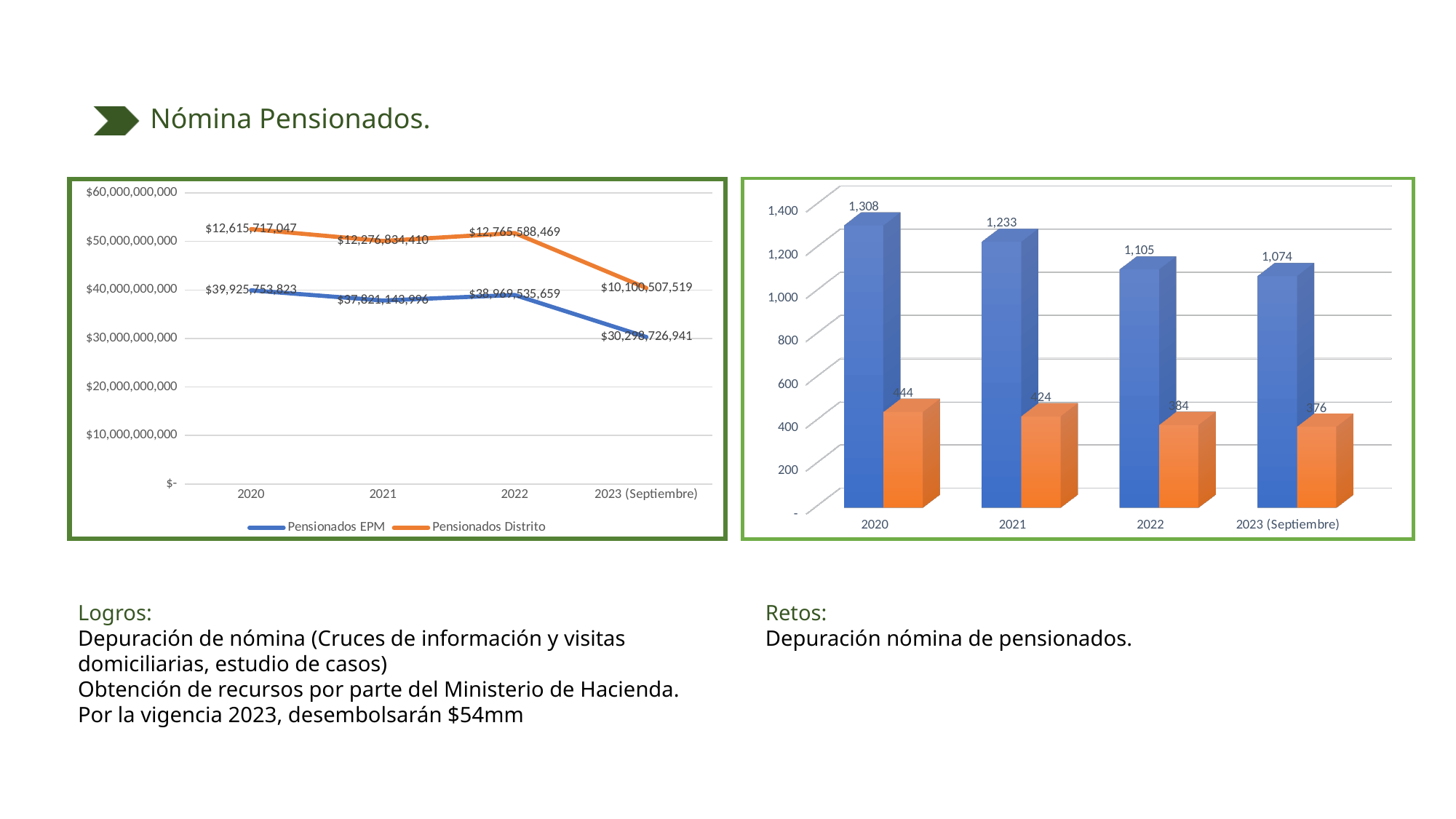
On the left chart, in which year is the Pensionados EPM value highest? 2020 What kind of chart is the chart on the right? Bar chart On the right chart, what is the value of the orange bar for 2022? 384 On the right chart, what is the value of the blue bar for 2021? 1,233 On the left chart, what is the value for Pensionados EPM in 2023 (Septiembre)? $30,298,726,941 On the left chart, in which year is the Pensionados Distrito value lowest? 2023 (Septiembre) On the left chart, how many series does the legend list? 2 On the left chart, what is the value for Pensionados Distrito in 2021? $12,276,834,410 On the right chart, do the blue bar values rise or fall from 2020 to 2023 (Septiembre)? Fall On the right chart, what is the difference between the blue bar values for 2020 and 2023 (Septiembre)? 234 What kind of chart is the chart on the left? Line chart On the right chart, how many categories are shown on the x axis? 4